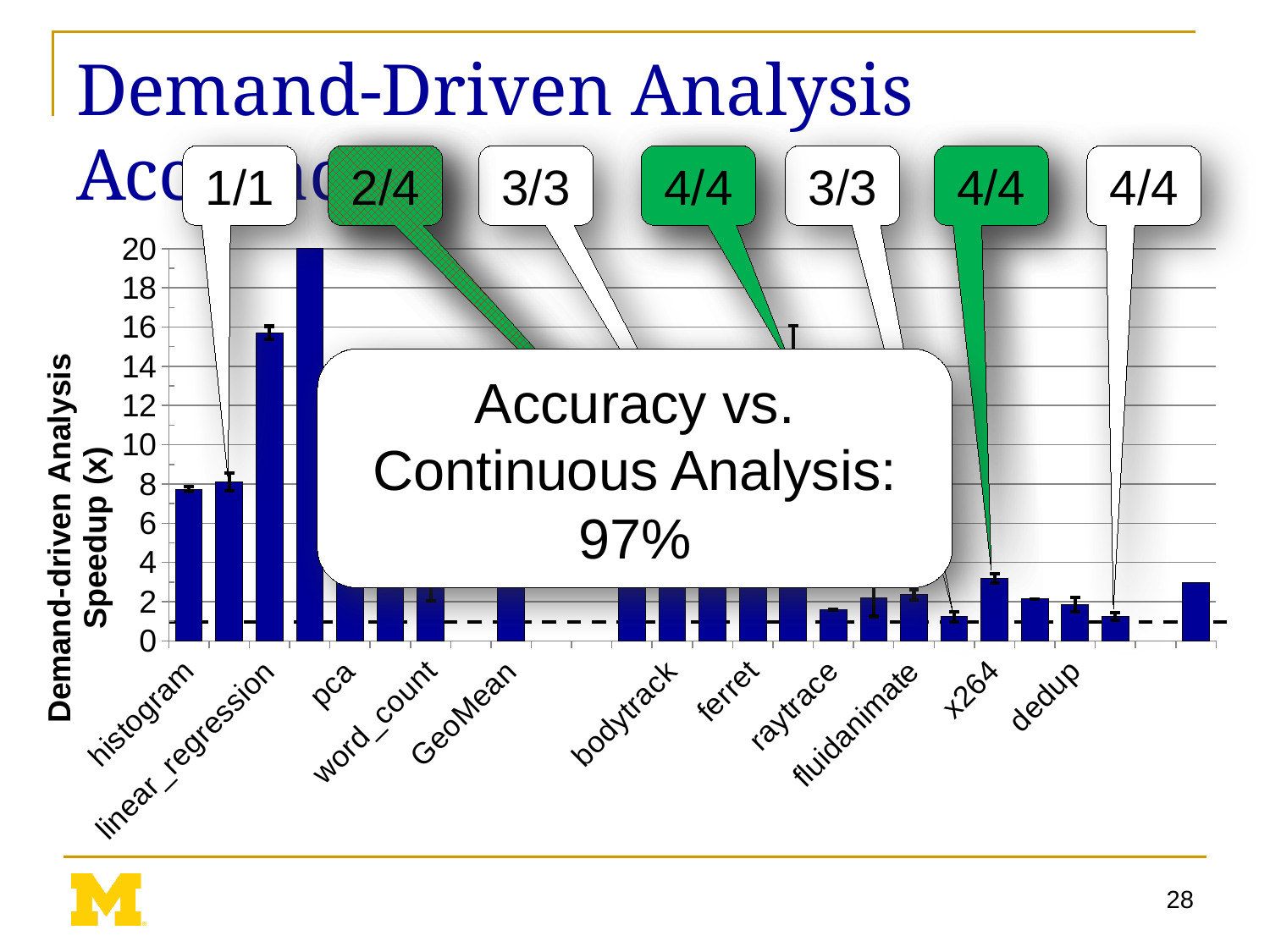
What kind of chart is shown on the slide? bar chart What is the title of the y axis of the chart? Demand-driven Analysis Speedup (x) Is the value for histogram greater or less than 10? less Is the value for histogram greater or less than 4? greater What accuracy versus continuous analysis is stated in the box overlaid on the chart? 97% How many category labels are shown along the x axis of the chart? 11